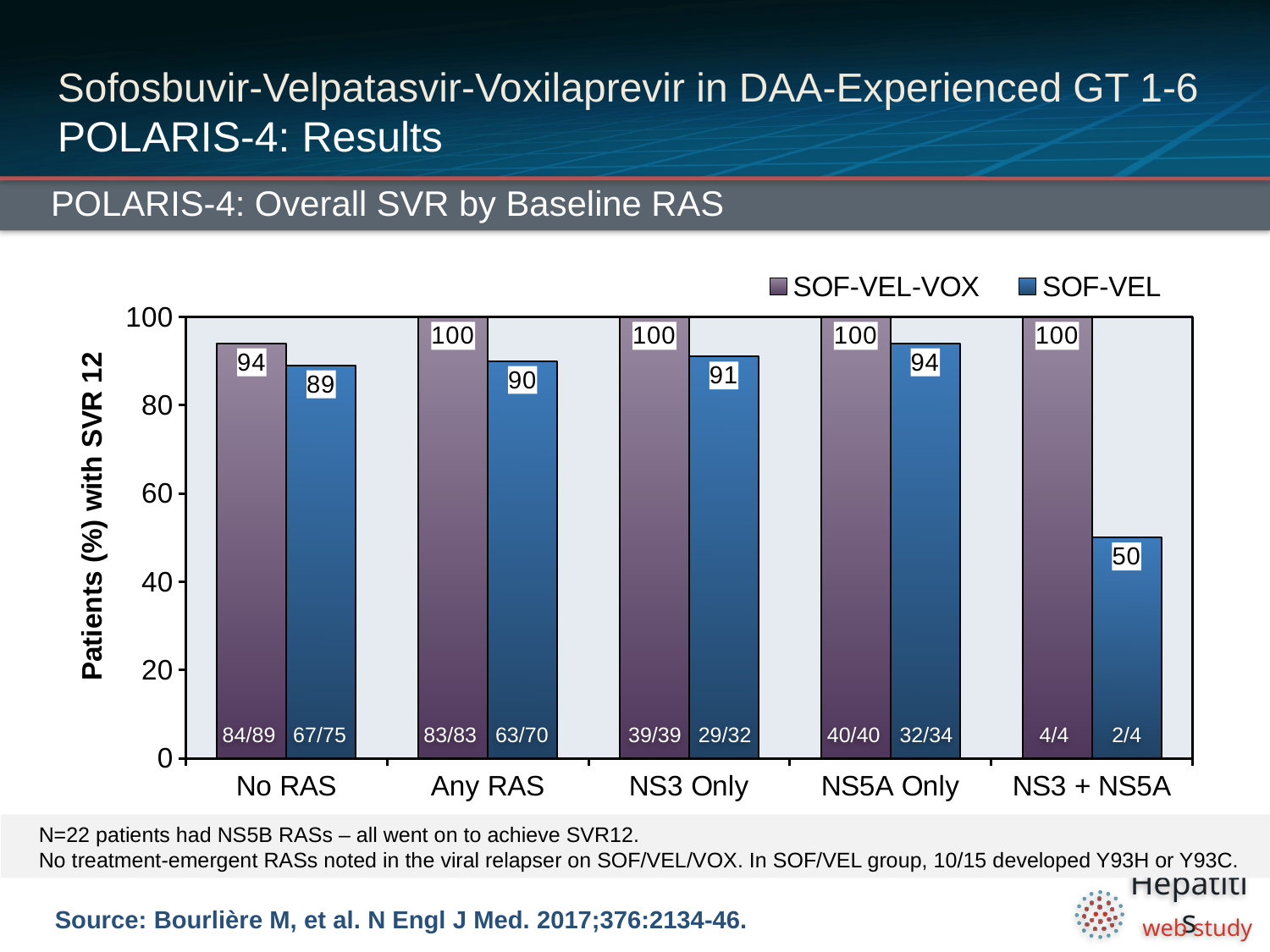
What is the SVR 12 rate for SOF-VEL in the NS3 Only group? 91 What is the SVR 12 rate for SOF-VEL in the NS3 + NS5A group? 50 In the NS5A Only group, which regimen has the higher SVR 12 rate, SOF-VEL-VOX or SOF-VEL? SOF-VEL-VOX Is the SOF-VEL value for NS3 + NS5A greater or less than 60? less How many series does the legend list? 2 What is the label of the y axis? Patients (%) with SVR 12 What kind of chart is shown on the slide? Bar chart What is the difference between the SOF-VEL-VOX and SOF-VEL SVR 12 rates in the Any RAS group? 10 What is the SVR 12 rate for SOF-VEL-VOX in the No RAS group? 94 What is the difference between the SOF-VEL-VOX and SOF-VEL SVR 12 rates in the NS3 + NS5A group? 50 Which baseline RAS category has the lowest SVR 12 rate for SOF-VEL? NS3 + NS5A How many baseline RAS categories are shown on the x axis? 5